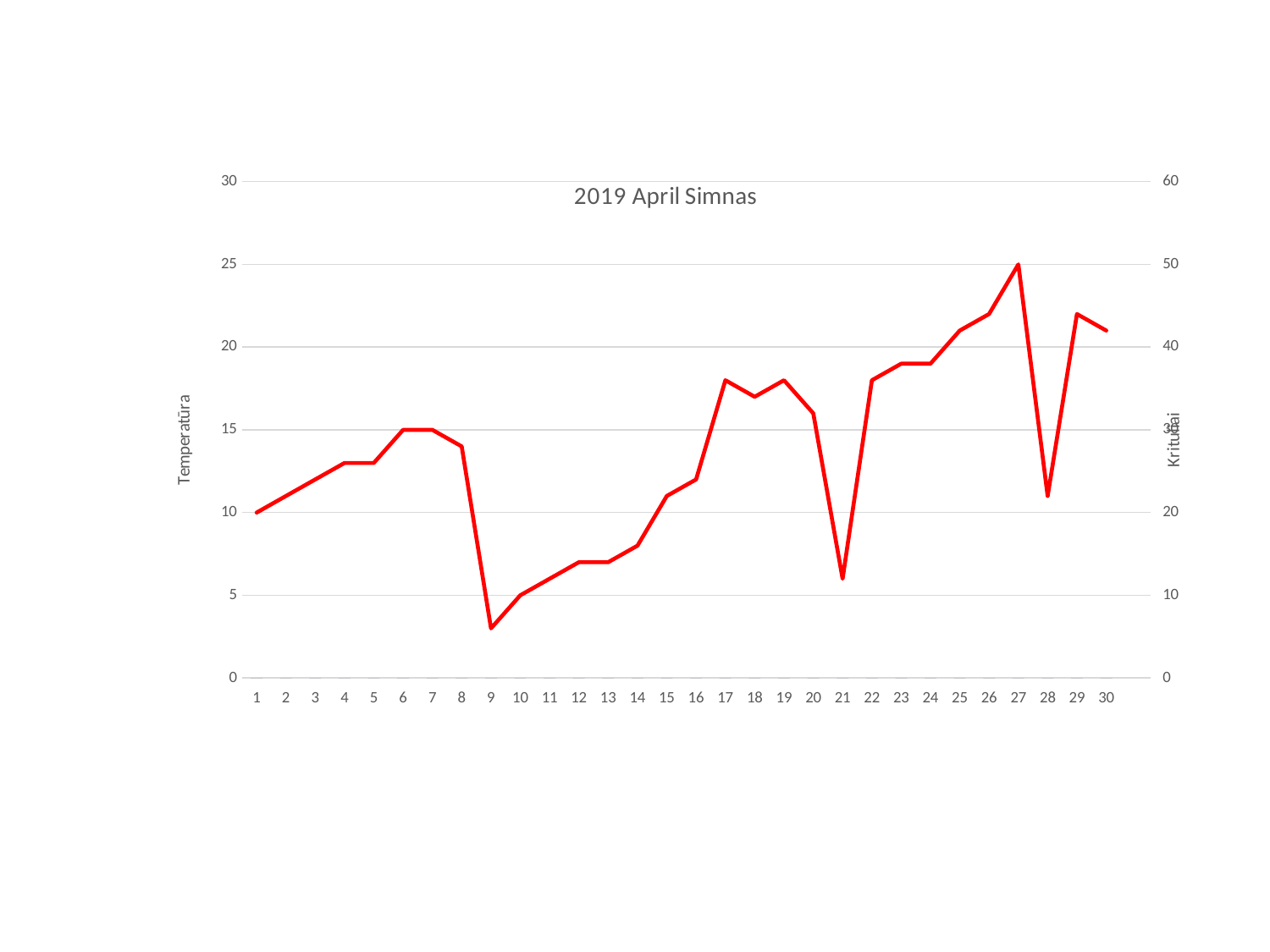
What kind of chart is shown on the slide? line chart What is the label of the left vertical axis? Temperatūra On which day does the line reach its highest value? 27 What is the value on the left axis for day 27? 25 Which day has the larger value, day 17 or day 9? 17 What is the value on the left axis for day 1? 10 Is the value for day 21 greater or less than 10 on the left axis? less Is the value for day 9 greater or less than 5 on the left axis? less How many days are plotted along the x axis? 30 On which day does the line reach its lowest value? 9 Overall, does the line rise or fall from day 1 to day 30? rise What is the title of the chart? 2019 April Simnas